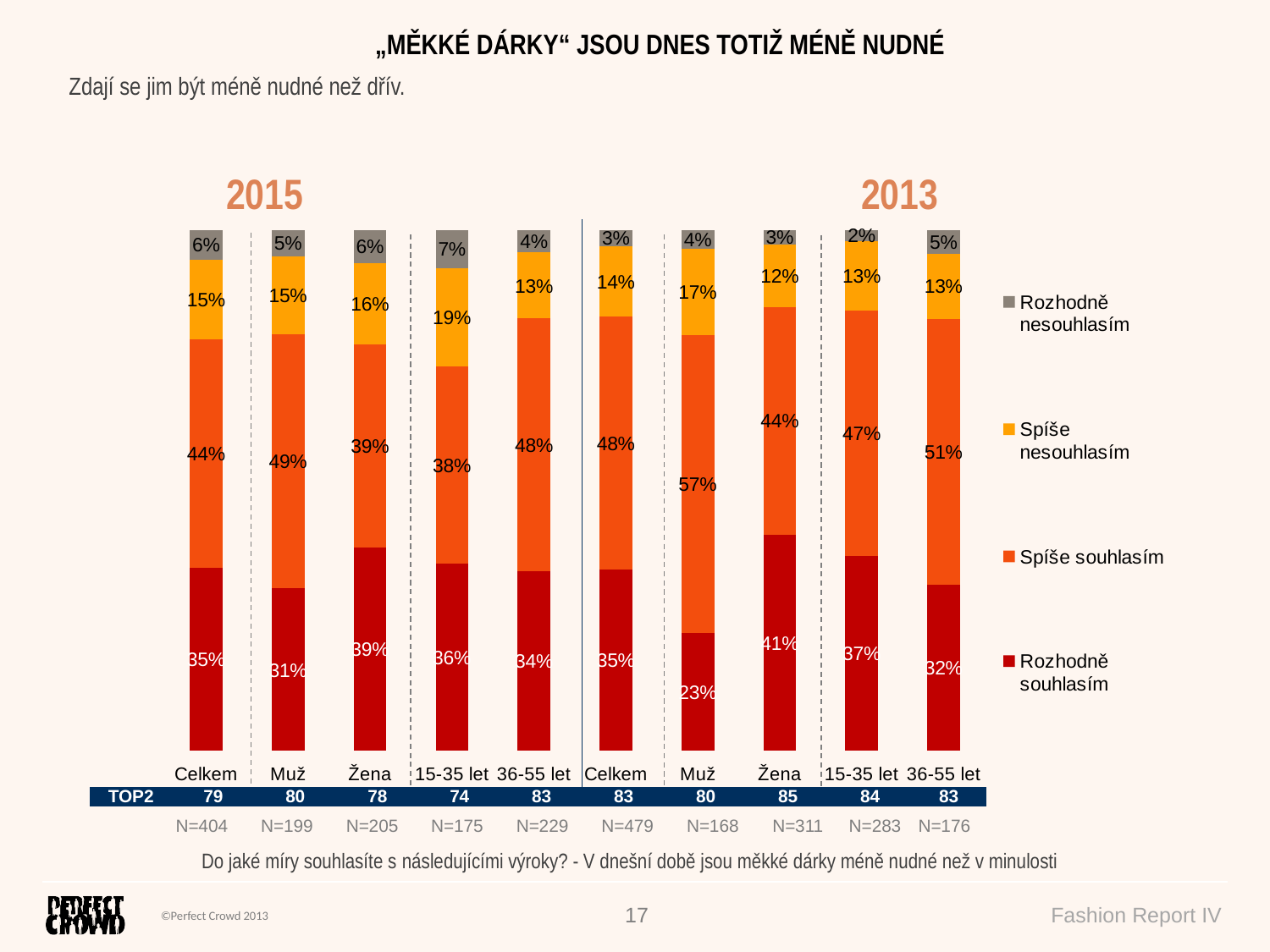
Which is larger: the "Spíše souhlasím" value for Celkem in 2015 or for Celkem in 2013? Celkem in 2013 In the 2015 group, which category has the lowest "Rozhodně nesouhlasím" value? 36-55 let What is the difference between the "Rozhodně souhlasím" values for Žena in 2013 and Žena in 2015? 2% In the 2015 group, what is the value of "Spíše nesouhlasím" for 15-35 let? 19% How many series does the legend list? 4 In the 2013 group, which category has the highest "Spíše souhlasím" value? Muž What kind of chart is shown on the slide? stacked bar chart What is the TOP2 value shown for Žena in the 2013 group? 85 In the 2015 group, what is the value of "Spíše souhlasím" for Muž? 49% How many bars are plotted in the chart in total? 10 In the 2013 group, what is the value of "Rozhodně nesouhlasím" for 15-35 let? 2% In the 2013 group, what is the value of "Rozhodně souhlasím" for Muž? 23%